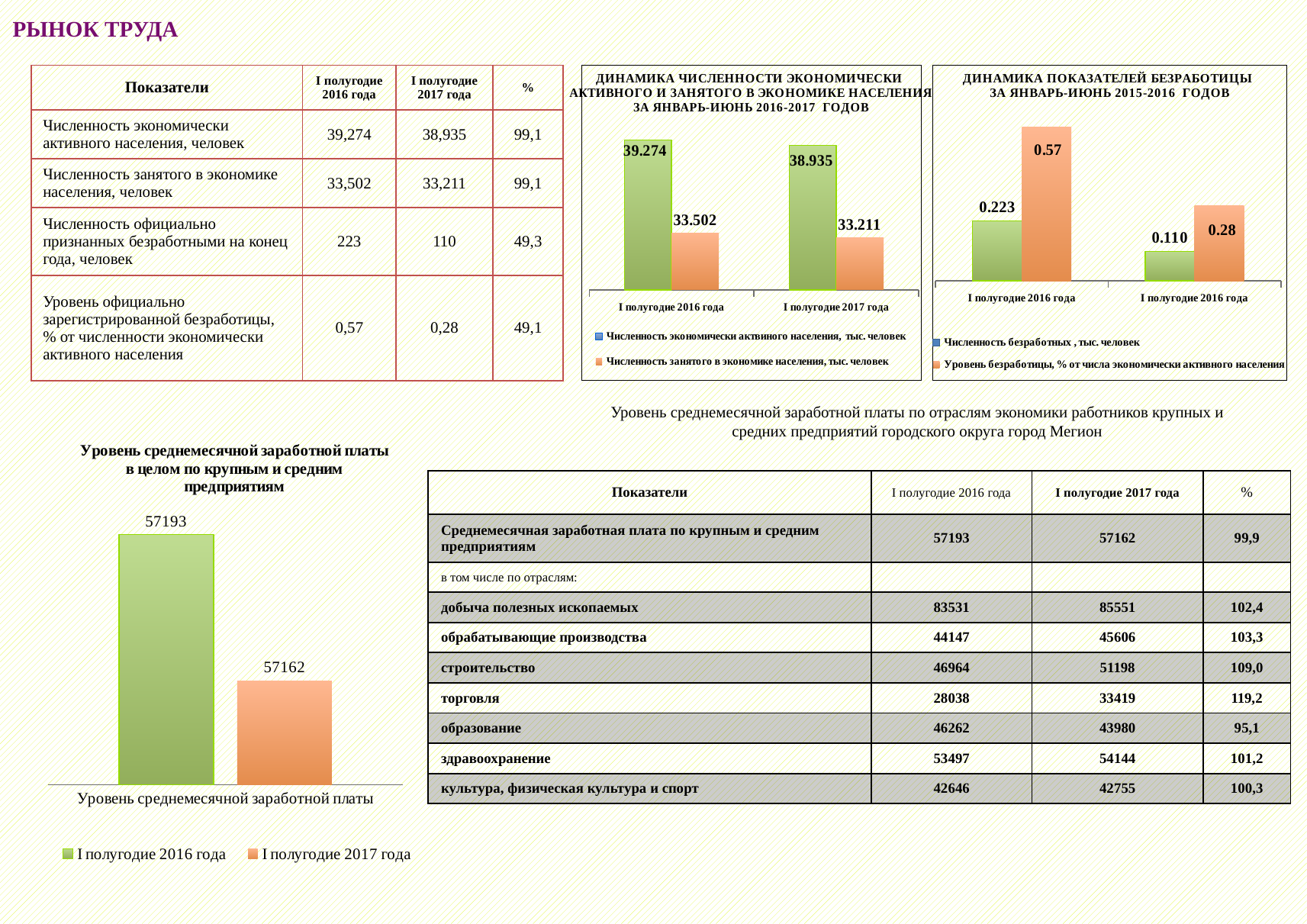
In the chart titled 'Уровень среднемесячной заработной платы в целом по крупным и средним предприятиям', what is the value for I полугодие 2017 года? 57162 In the chart titled 'ДИНАМИКА ПОКАЗАТЕЛЕЙ БЕЗРАБОТИЦЫ', what is the value of the orange bar (unemployment rate) in the left group? 0.57 In the chart titled 'ДИНАМИКА ЧИСЛЕННОСТИ ЭКОНОМИЧЕСКИ АКТИВНОГО И ЗАНЯТОГО В ЭКОНОМИКЕ НАСЕЛЕНИЯ', what is the value of the employed population (orange bar) for I полугодие 2017 года? 33.211 In the chart titled 'ДИНАМИКА ЧИСЛЕННОСТИ ЭКОНОМИЧЕСКИ АКТИВНОГО И ЗАНЯТОГО В ЭКОНОМИКЕ НАСЕЛЕНИЯ', what is the value of the economically active population (green bar) for I полугодие 2016 года? 39.274 In the chart titled 'ДИНАМИКА ПОКАЗАТЕЛЕЙ БЕЗРАБОТИЦЫ', what kind of chart is shown? bar chart In the chart titled 'ДИНАМИКА ЧИСЛЕННОСТИ ЭКОНОМИЧЕСКИ АКТИВНОГО И ЗАНЯТОГО В ЭКОНОМИКЕ НАСЕЛЕНИЯ', which is larger: the economically active population in I полугодие 2016 года or in I полугодие 2017 года? I полугодие 2016 года In the chart titled 'Уровень среднемесячной заработной платы в целом по крупным и средним предприятиям', what is the difference between the I полугодие 2016 года and I полугодие 2017 года values? 31 In the chart titled 'Уровень среднемесячной заработной платы в целом по крупным и средним предприятиям', what colour is the bar for I полугодие 2016 года? green In the chart titled 'ДИНАМИКА ПОКАЗАТЕЛЕЙ БЕЗРАБОТИЦЫ', what is the value of the green bar (number of unemployed) in the right group? 0.110 In the chart titled 'ДИНАМИКА ЧИСЛЕННОСТИ ЭКОНОМИЧЕСКИ АКТИВНОГО И ЗАНЯТОГО В ЭКОНОМИКЕ НАСЕЛЕНИЯ', does the employed population rise or fall from I полугодие 2016 года to I полугодие 2017 года? fall In the chart titled 'ДИНАМИКА ЧИСЛЕННОСТИ ЭКОНОМИЧЕСКИ АКТИВНОГО И ЗАНЯТОГО В ЭКОНОМИКЕ НАСЕЛЕНИЯ', how many series does the legend list? 2 In the chart titled 'ДИНАМИКА ПОКАЗАТЕЛЕЙ БЕЗРАБОТИЦЫ', which bar has the highest value? The orange bar (Уровень безработицы) in the left group, with value 0.57